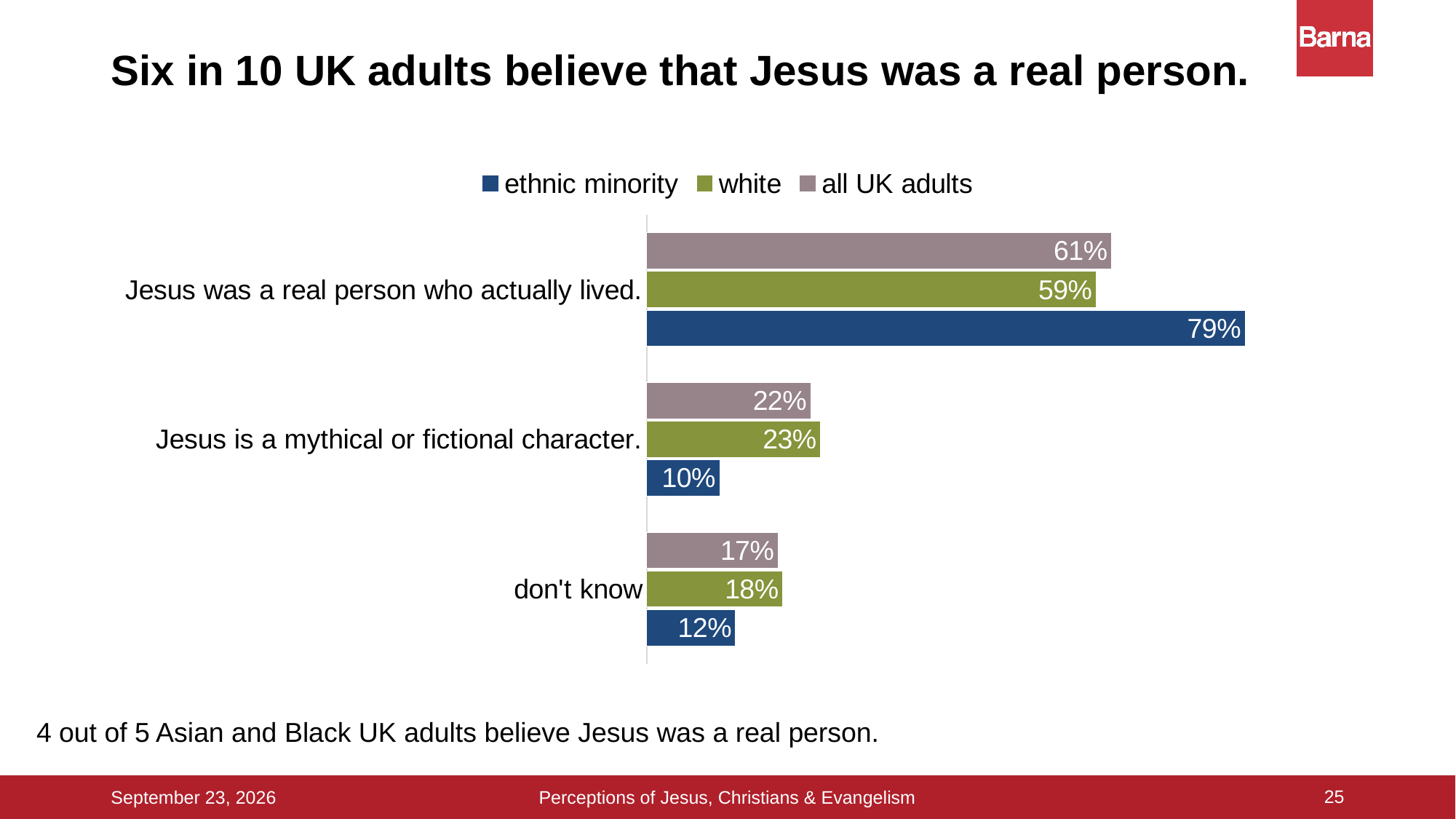
What percentage of white respondents say Jesus is a mythical or fictional character? 23% What percentage of ethnic minority respondents say Jesus was a real person who actually lived? 79% Which group has the lowest value for 'Jesus is a mythical or fictional character'? ethnic minority Which group has the highest value for 'Jesus was a real person who actually lived'? ethnic minority What percentage of all UK adults believe Jesus was a real person who actually lived? 61% What is the difference between the ethnic minority and white values for 'Jesus was a real person who actually lived'? 20 percentage points How many response categories are shown on the chart? 3 Which is larger for 'don't know': the white value or the all UK adults value? white What is the difference between the white and ethnic minority values for 'Jesus is a mythical or fictional character'? 13 percentage points How many series does the legend list? 3 What kind of chart is shown on the slide? bar chart What percentage of ethnic minority respondents answered 'don't know'? 12%